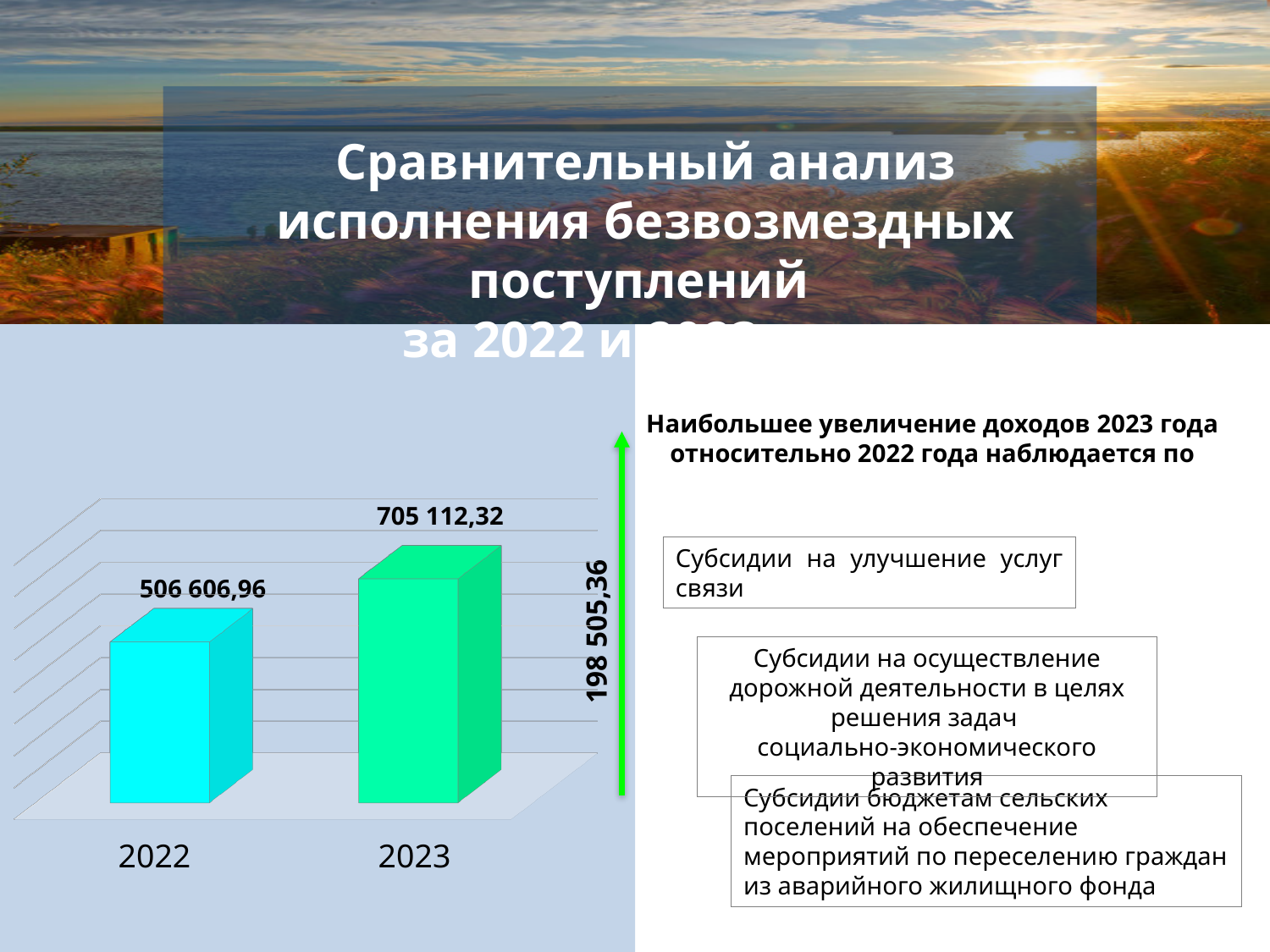
What colour is the bar for 2023? green Which year has the lower value? 2022 What is the value shown for 2022? 506 606,96 What number is written next to the green arrow beside the chart? 198 505,36 Do the values rise or fall from 2022 to 2023? rise What is the difference between the 2023 value and the 2022 value? 198 505,36 Is the value for 2023 larger or smaller than the value for 2022? larger What kind of chart is shown on the slide? bar chart Which year has the higher value? 2023 How many bars are plotted in the chart? 2 What is the value shown for 2023? 705 112,32